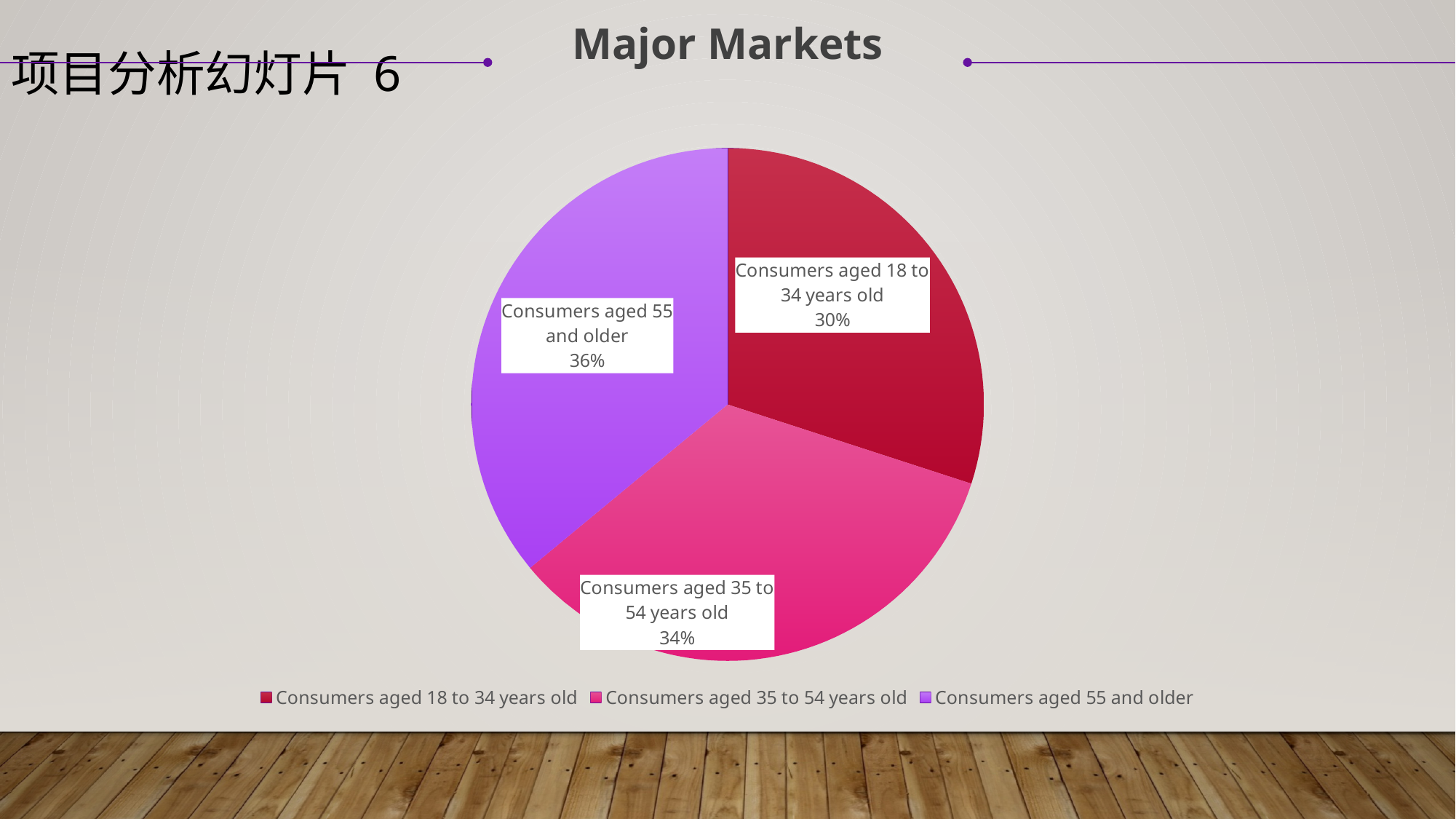
What is the difference in percentage points between Consumers aged 55 and older and Consumers aged 18 to 34 years old? 6 How many slices does the pie chart have? 3 What share of the pie is taken by Consumers aged 35 to 54 years old? 34% What share of the pie is taken by Consumers aged 18 to 34 years old? 30% How many entries does the legend list? 3 What is the difference in percentage points between Consumers aged 35 to 54 years old and Consumers aged 18 to 34 years old? 4 What is the title of the chart? Major Markets What share of the pie is taken by Consumers aged 55 and older? 36% Which has a larger share: Consumers aged 35 to 54 years old or Consumers aged 55 and older? Consumers aged 55 and older What type of chart is shown on the slide? Pie chart Which category has the smallest share of the pie? Consumers aged 18 to 34 years old Which category has the largest share of the pie? Consumers aged 55 and older